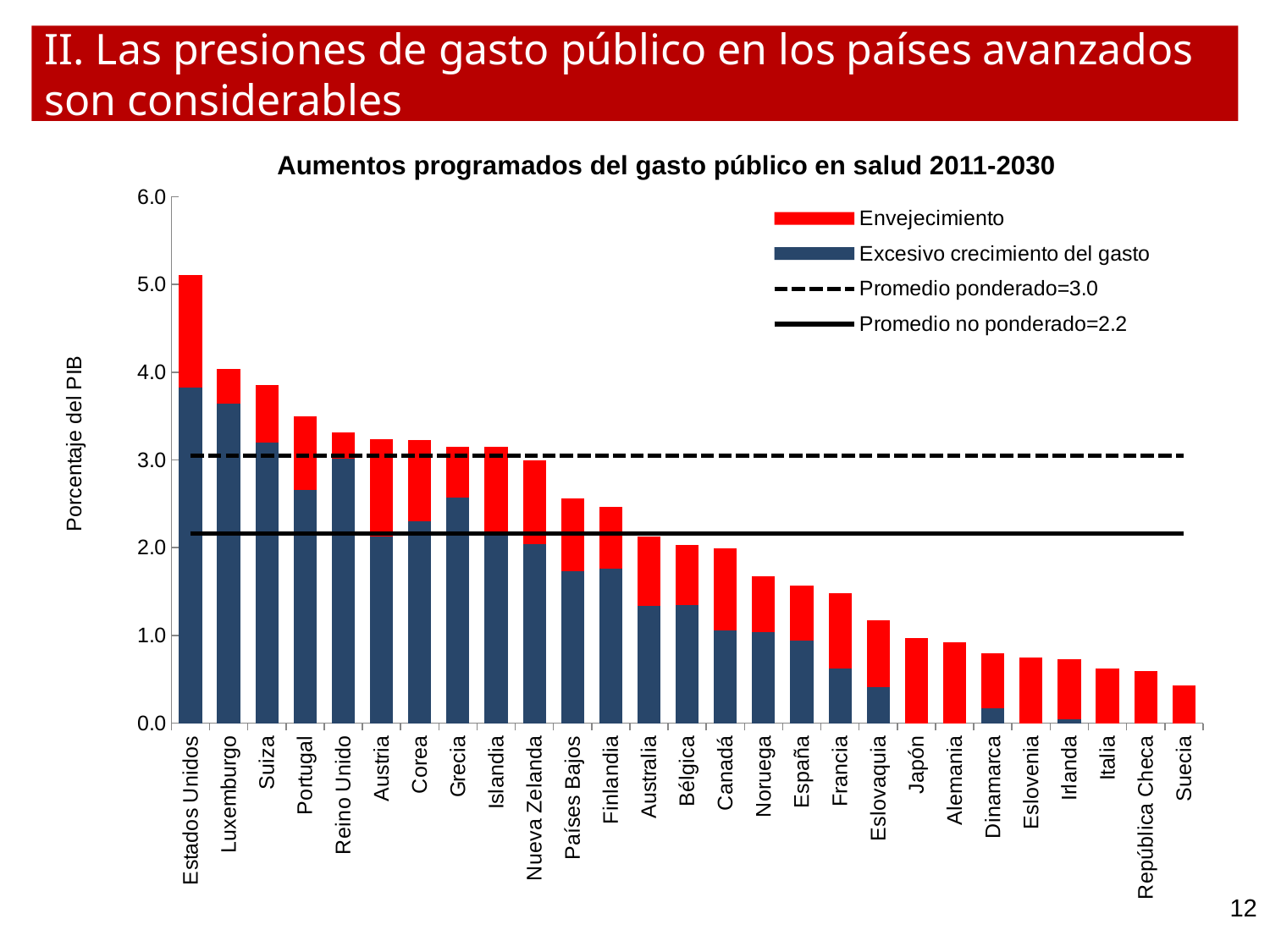
What kind of chart is shown on the slide? Stacked bar chart How many entries does the chart legend list? 4 What is the title of the chart? Aumentos programados del gasto público en salud 2011-2030 Is the total value for Noruega greater or less than 2.0? less Is the total value for Estados Unidos greater or less than 4.0? greater What is the label of the vertical axis? Porcentaje del PIB Is the total value for Suiza greater or less than 4.0? less Do the total bar values rise or fall moving from left to right along the x axis? fall Which country has the lowest total projected increase in public health spending? Suecia How many countries are shown on the x axis of the chart? 27 Which has a larger total value, Estados Unidos or Luxemburgo? Estados Unidos Which country has the highest total projected increase in public health spending? Estados Unidos